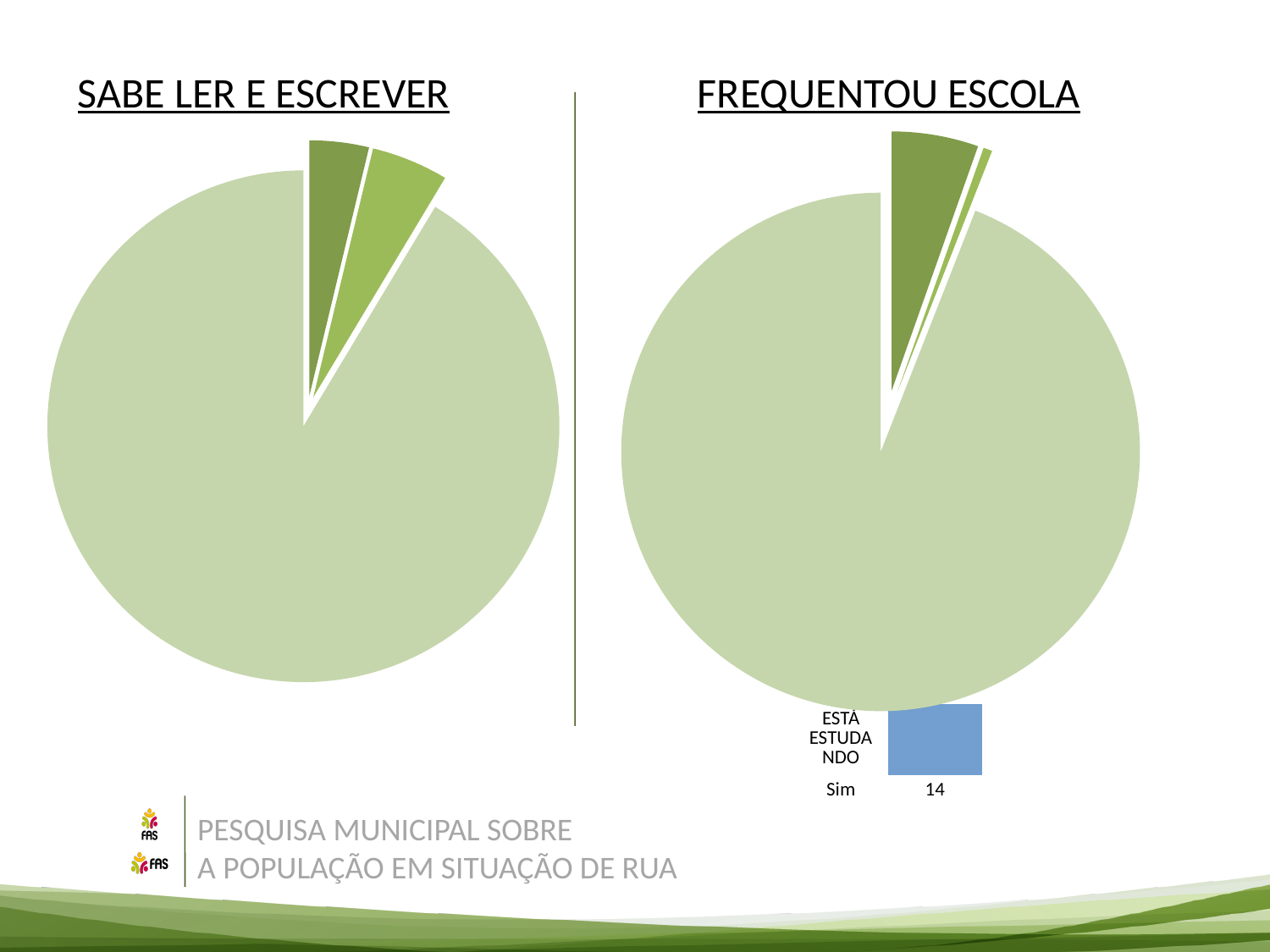
In the small chart at the bottom right labelled ESTÁ ESTUDANDO, what is the value shown for Sim? 14 What is the title of the pie chart on the right side of the slide? FREQUENTOU ESCOLA What kind of chart is the one titled FREQUENTOU ESCOLA? Pie chart How many slices does the pie chart titled FREQUENTOU ESCOLA have? 3 What is the title of the pie chart on the left side of the slide? SABE LER E ESCREVER What kind of chart is the one titled SABE LER E ESCREVER? Pie chart How many slices does the pie chart titled SABE LER E ESCREVER have? 3